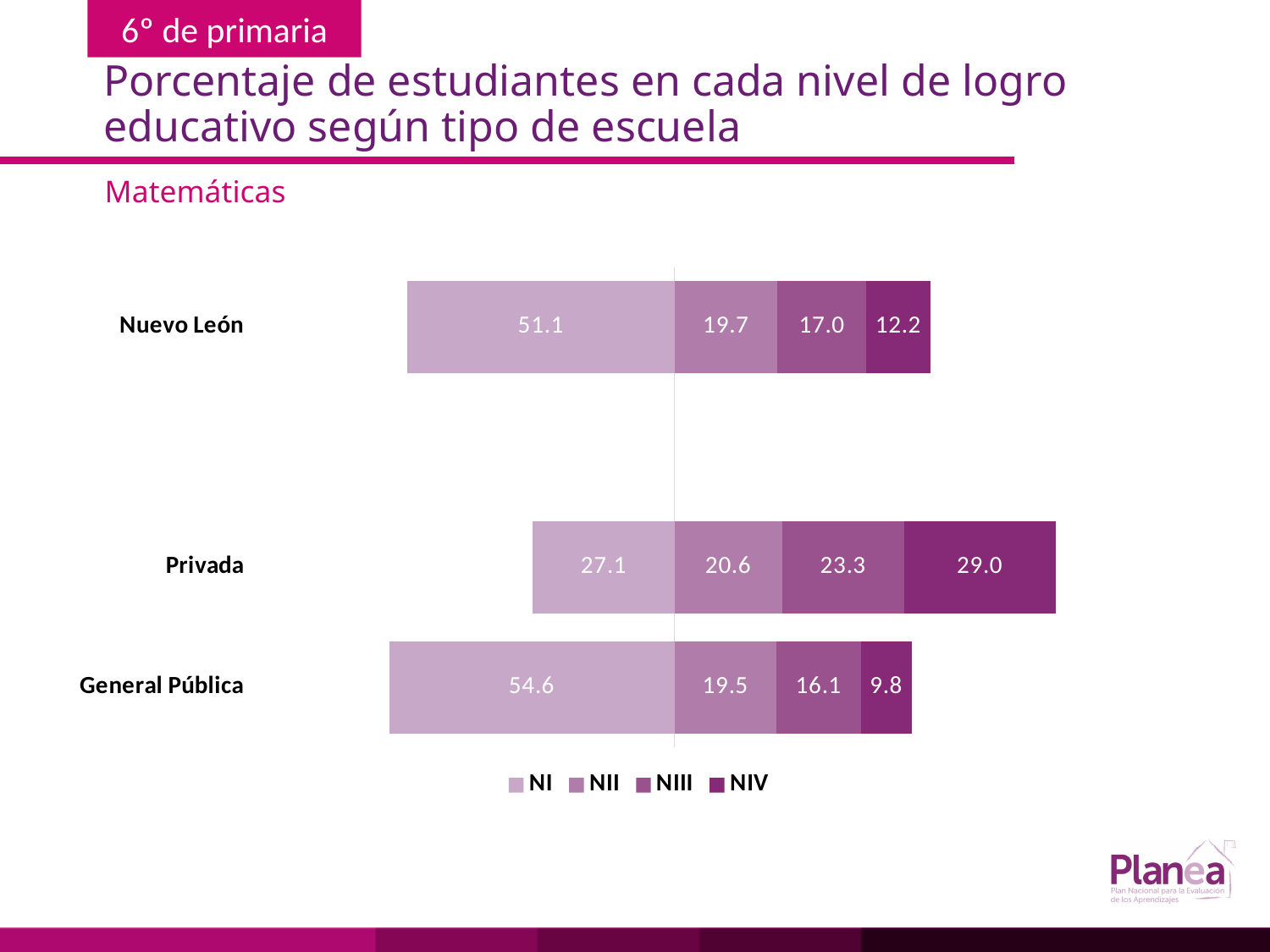
How many series does the legend list? 4 How many categories are shown on the chart? 3 Which category has the lowest NIV value? General Pública What is the total of the stacked bar for Nuevo León? 100.0 What kind of chart is shown? Stacked bar chart What is the NI value for Nuevo León? 51.1 What is the difference between the NI values for General Pública and Privada? 27.5 Which is larger: the NIII value for Privada or the NIII value for Nuevo León? Privada What is the NII value for Privada? 20.6 What is the NIII value for General Pública? 16.1 Which category has the highest NI value? General Pública What is the NIV value for Privada? 29.0